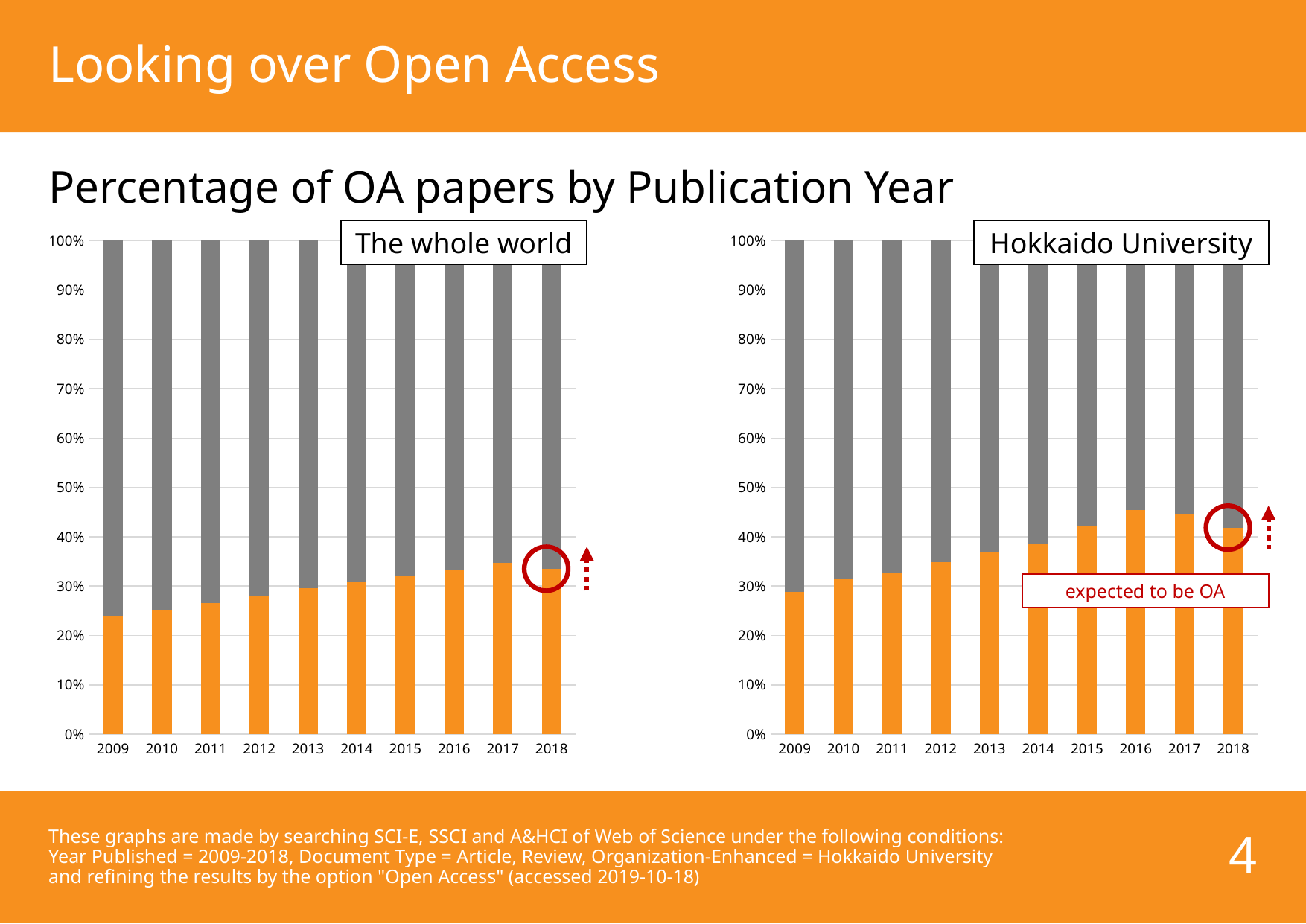
In 'The whole world' chart, is the orange (OA) value for 2018 greater or less than 30%? greater What kind of chart is used for 'The whole world'? bar chart In 'The whole world' chart, does the orange (OA) share rise or fall from 2009 to 2018? rise What does the red-bordered annotation on the 'Hokkaido University' chart say? expected to be OA In the 'Hokkaido University' chart, how many publication years are shown on the x axis? 10 In 'The whole world' chart, is the orange (OA) value for 2009 greater or less than 30%? less In the 'Hokkaido University' chart, which year has the larger orange (OA) share, 2009 or 2016? 2016 In 'The whole world' chart, which year has the lowest orange (OA) share? 2009 In the 'Hokkaido University' chart, is the orange (OA) value for 2012 greater or less than 40%? less In the 'Hokkaido University' chart, which year has the lowest orange (OA) share? 2009 In 'The whole world' chart, how many publication years are shown on the x axis? 10